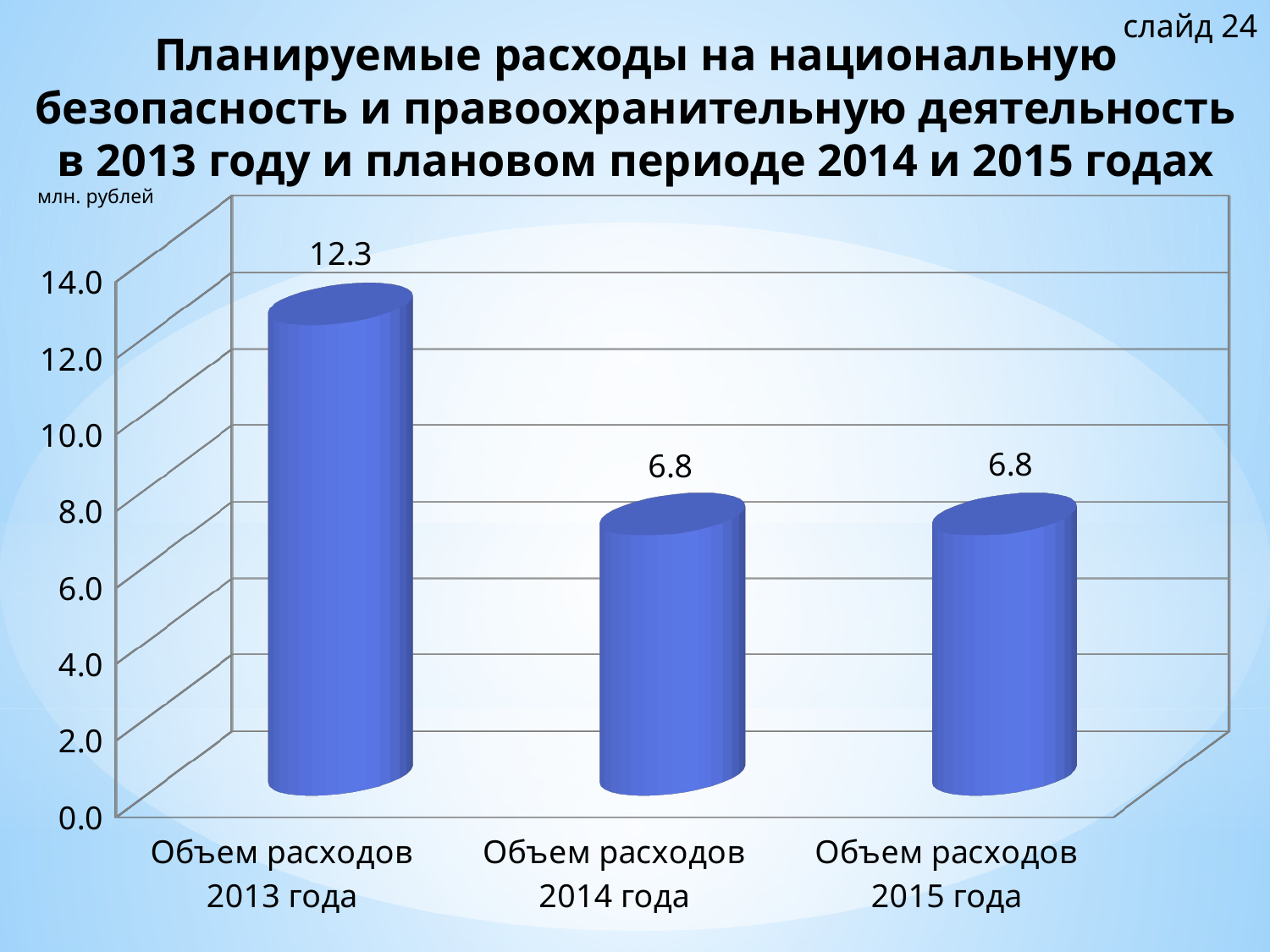
Is the value for Объем расходов 2013 года greater or less than 10.0? greater What kind of chart is shown on the slide? bar chart Which category has the highest value? Объем расходов 2013 года What unit is shown on the chart's axis label? млн. рублей What is the value for Объем расходов 2013 года? 12.3 Is the value for Объем расходов 2014 года greater or less than 8.0? less Which is larger, the value for Объем расходов 2013 года or Объем расходов 2015 года? Объем расходов 2013 года What is the value for Объем расходов 2015 года? 6.8 What is the difference between the values for Объем расходов 2013 года and Объем расходов 2014 года? 5.5 How many categories are shown in the chart? 3 What is the value for Объем расходов 2014 года? 6.8 Do the values rise or fall from Объем расходов 2013 года to Объем расходов 2014 года? fall